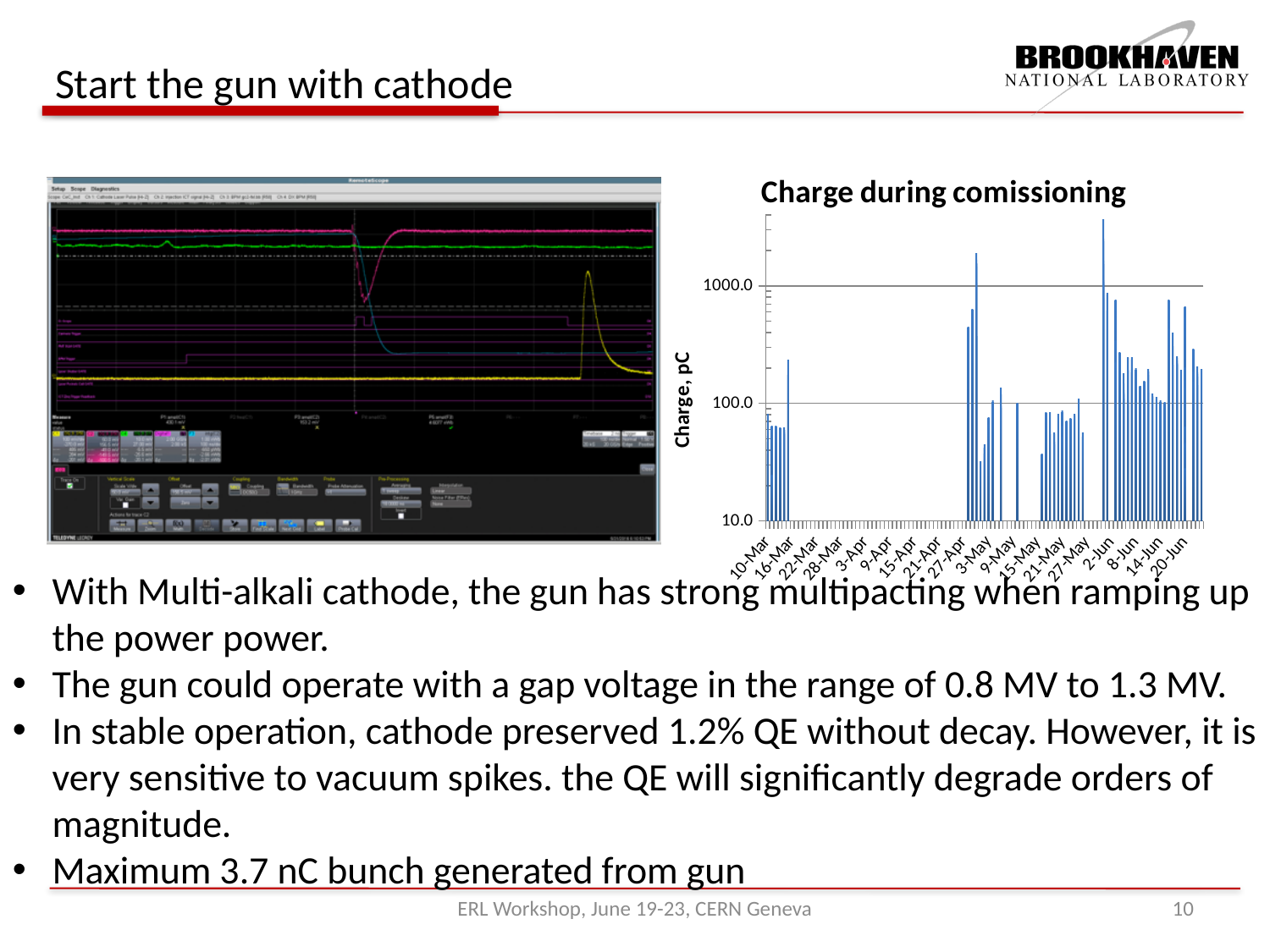
In the 'Charge during comissioning' chart, is the first bar near 10-Mar greater or less than 100.0 pC? less What is the y-axis label of the 'Charge during comissioning' chart? Charge, pC In the 'Charge during comissioning' chart, near which x-axis date does the highest bar occur? 2-Jun In the 'Charge during comissioning' chart, is the tallest bar (near 2-Jun) greater or less than 1000.0 pC? greater What kind of chart is 'Charge during comissioning'? bar chart In the 'Charge during comissioning' chart, is the spike near 3-May greater or less than 1000.0 pC? greater What is the title of the chart on the right of the slide? Charge during comissioning